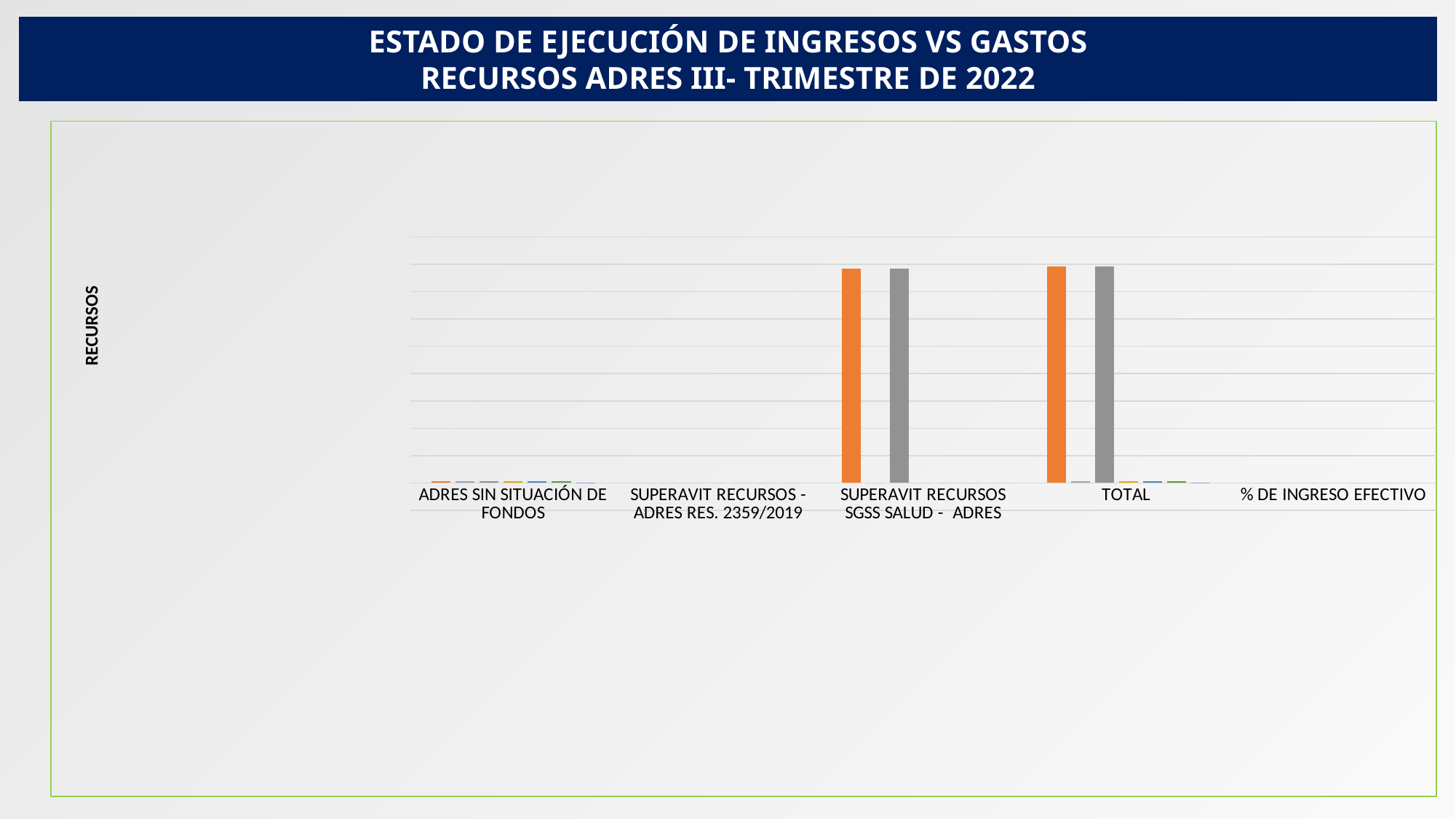
Which category has a taller orange bar, TOTAL or SUPERAVIT RECURSOS - ADRES RES. 2359/2019? TOTAL Which category has a taller grey bar, SUPERAVIT RECURSOS SGSS SALUD - ADRES or ADRES SIN SITUACIÓN DE FONDOS? SUPERAVIT RECURSOS SGSS SALUD - ADRES What kind of chart is shown on the slide? Bar chart What is the label of the last category on the x axis of the chart? % DE INGRESO EFECTIVO What is the title of the chart on the slide? ESTADO DE EJECUCIÓN DE INGRESOS VS GASTOS RECURSOS ADRES III- TRIMESTRE DE 2022 How many categories are shown along the x axis of the chart? 5 What is the label on the vertical axis of the chart? RECURSOS Which category has a taller orange bar, % DE INGRESO EFECTIVO or SUPERAVIT RECURSOS SGSS SALUD - ADRES? SUPERAVIT RECURSOS SGSS SALUD - ADRES